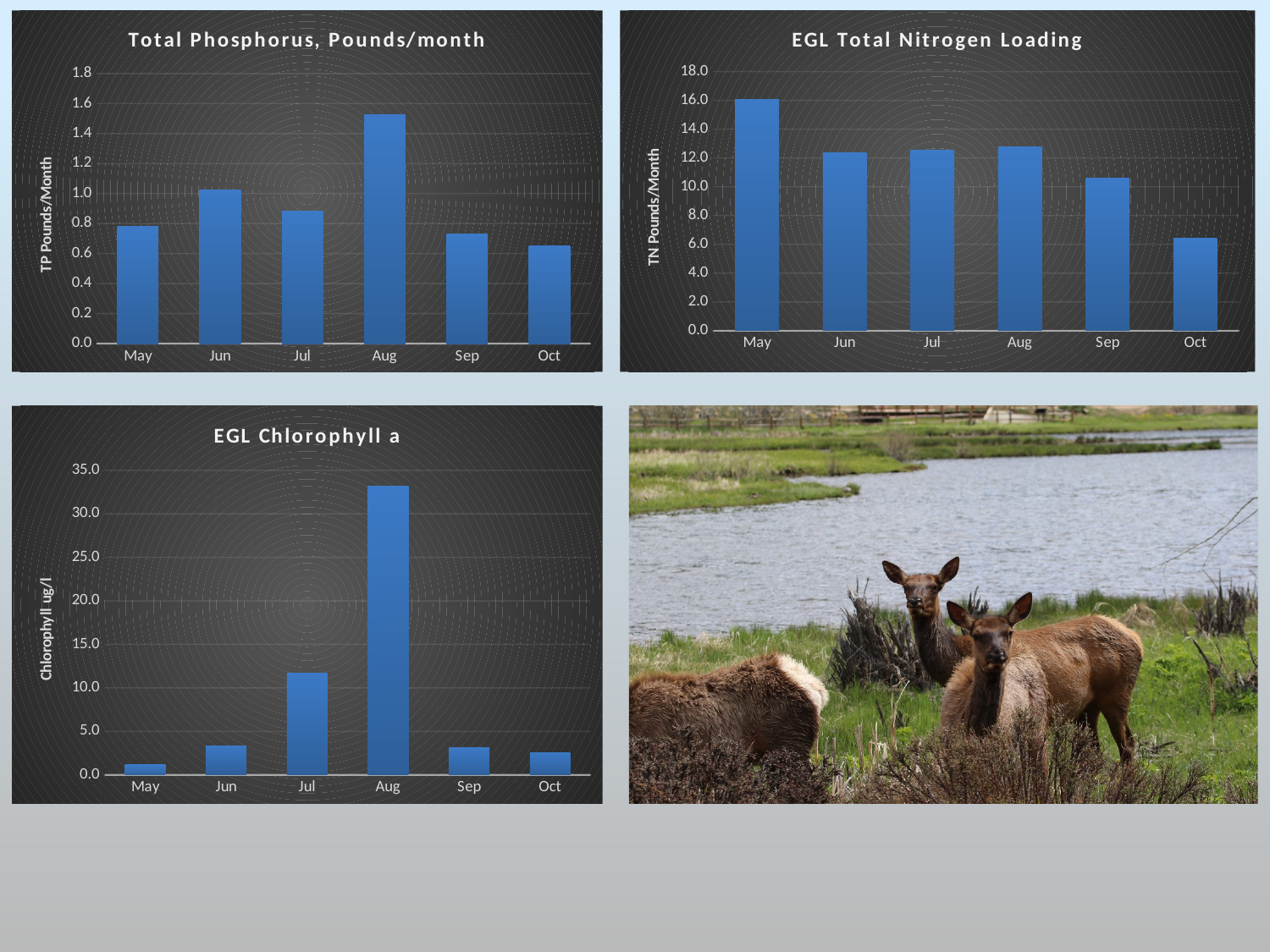
In the EGL Chlorophyll a chart, which month has the lowest value? May How many months are shown on the x axis of the EGL Chlorophyll a chart? 6 In the Total Phosphorus, Pounds/month chart, is the value for Aug greater or less than 1.4? greater In the EGL Chlorophyll a chart, is the value for Jul greater or less than 10.0? greater In the Total Phosphorus, Pounds/month chart, which month has the highest value? Aug In the EGL Total Nitrogen Loading chart, which month has the highest value? May In the EGL Chlorophyll a chart, which month has the highest value? Aug In the Total Phosphorus, Pounds/month chart, is the value for Jun greater or less than 1.2? less In the EGL Total Nitrogen Loading chart, which month has the lowest value? Oct In the Total Phosphorus, Pounds/month chart, which is larger, the value for Jun or the value for Jul? Jun